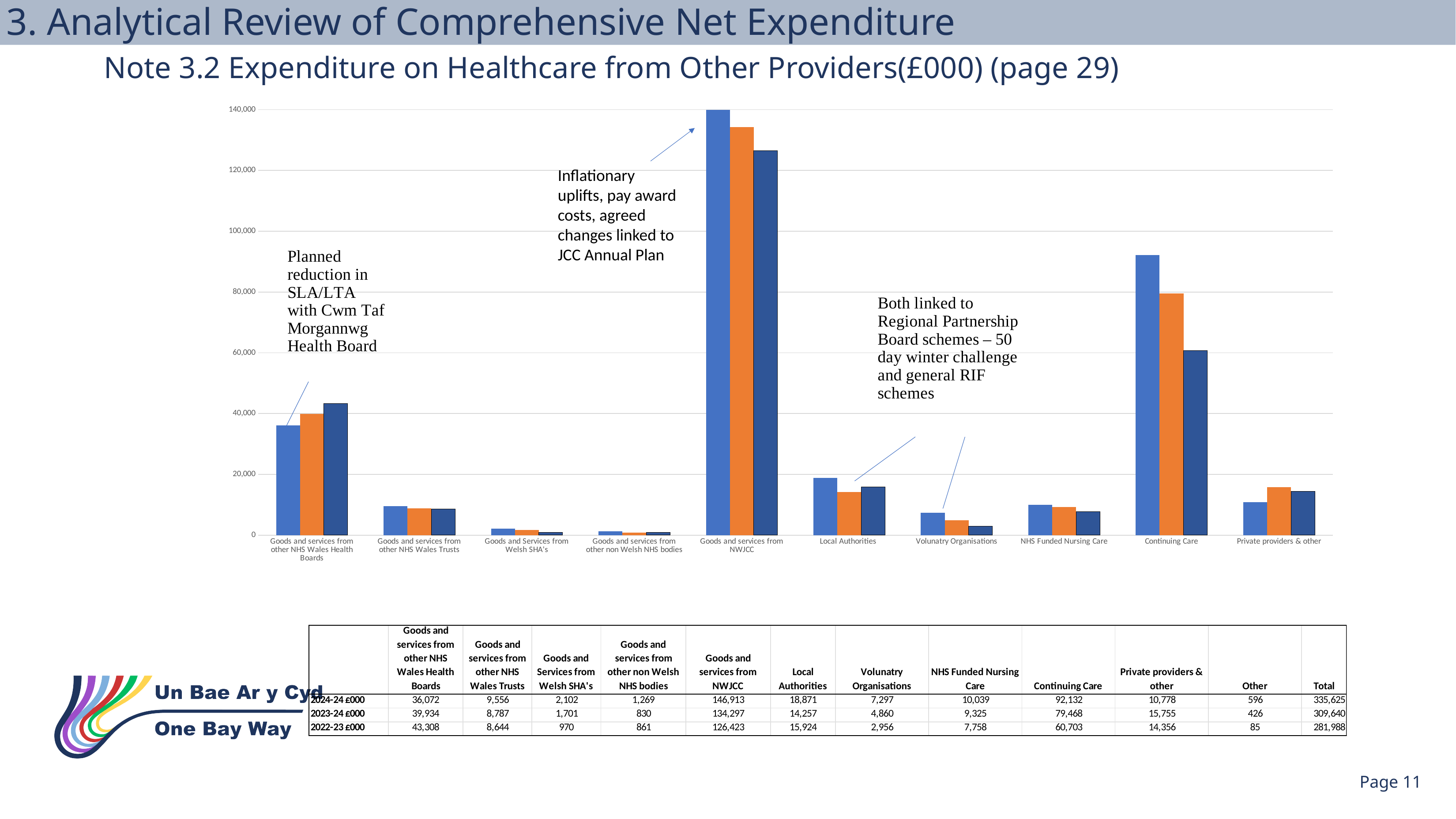
What is the Total for 2024-24 £000 shown in the table? 335,625 What is the difference between the 2024-24 and 2023-24 values for Goods and services from NWJCC? 12,616 Which category has the tallest bars on the chart? Goods and services from NWJCC Which category has the lowest 2024-24 £000 value in the table? Other According to the table, what is the 2024-24 £000 value for Continuing Care? 92,132 According to the table, what is the 2022-23 £000 value for Local Authorities? 15,924 What kind of chart is shown on the slide? Bar chart What is the difference between the 2024-24 and 2022-23 values for Voluntary Organisations? 4,341 Is the tallest bar for Continuing Care greater or less than 80,000? greater In 2024-24, which is larger: Continuing Care or Local Authorities? Continuing Care How many categories are plotted along the x axis of the chart? 10 Do the values for Goods and services from other NHS Wales Health Boards rise or fall from 2022-23 to 2024-24? Fall